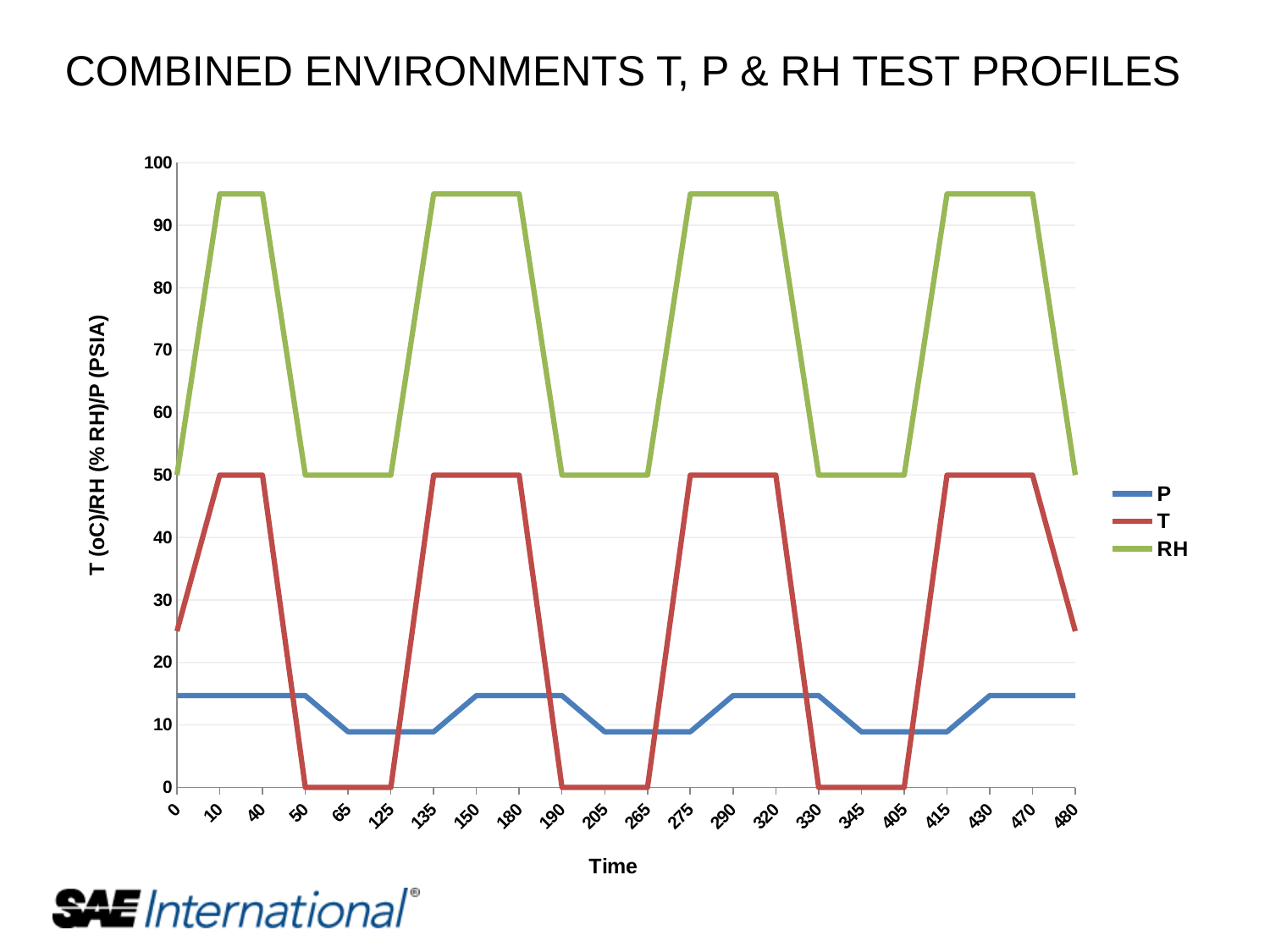
Is the value of P at time 65 greater or less than 10? less Is the value of RH at time 10 greater or less than 90? greater What are the series names listed in the legend? P, T, RH What is the title of the x axis? Time How many time points are labelled on the x axis? 22 Which series has the highest value at time 10? RH At time 0, which is larger, the value of RH or the value of T? RH What is the value of RH at time 0? 50 How many series does the legend list? 3 What is the value of T at time 10? 50 What is the value of T at time 50? 0 What kind of chart is shown on the slide? line chart